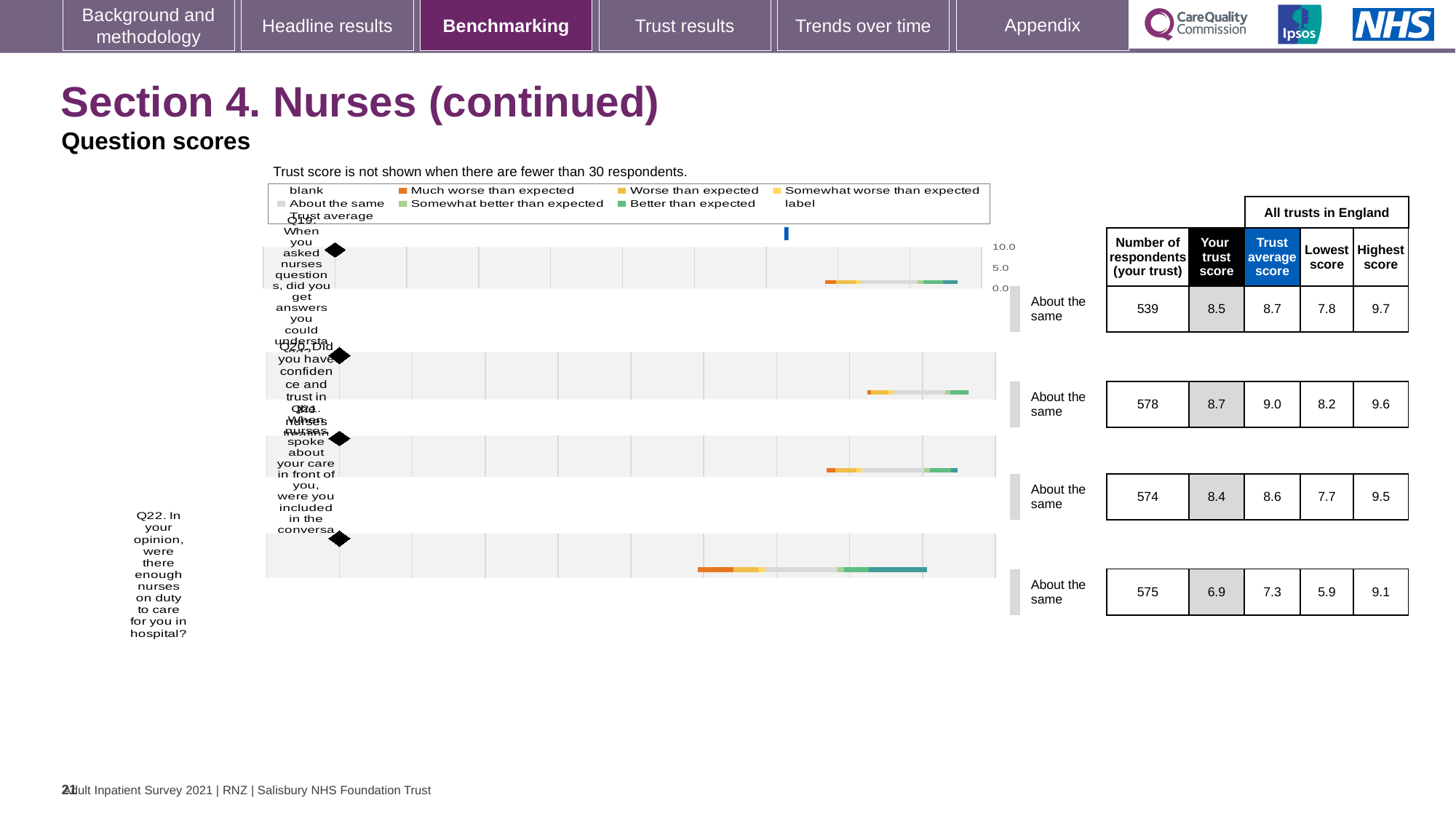
What benchmark category is shown for every question on this slide? About the same For Q19, is your trust score higher or lower than the trust average score? lower What is the difference between the highest and lowest scores in England for Q20? 1.4 Which question has the highest 'Your trust score' on this slide? Q20 Is your trust score for Q21 greater or less than 5.0? greater What is the 'Your trust score' for Q22 (were there enough nurses on duty to care for you in hospital)? 6.9 What is the difference between the trust average score and your trust score for Q22? 0.4 What is the highest score across all trusts in England for Q19? 9.7 What is the lowest score across all trusts in England for Q22? 5.9 How many respondents from your trust answered Q20 (did you have confidence and trust in the nurses treating you)? 578 How many questions are plotted in the chart on this slide? 4 Which question has the lowest 'Your trust score' on this slide? Q22